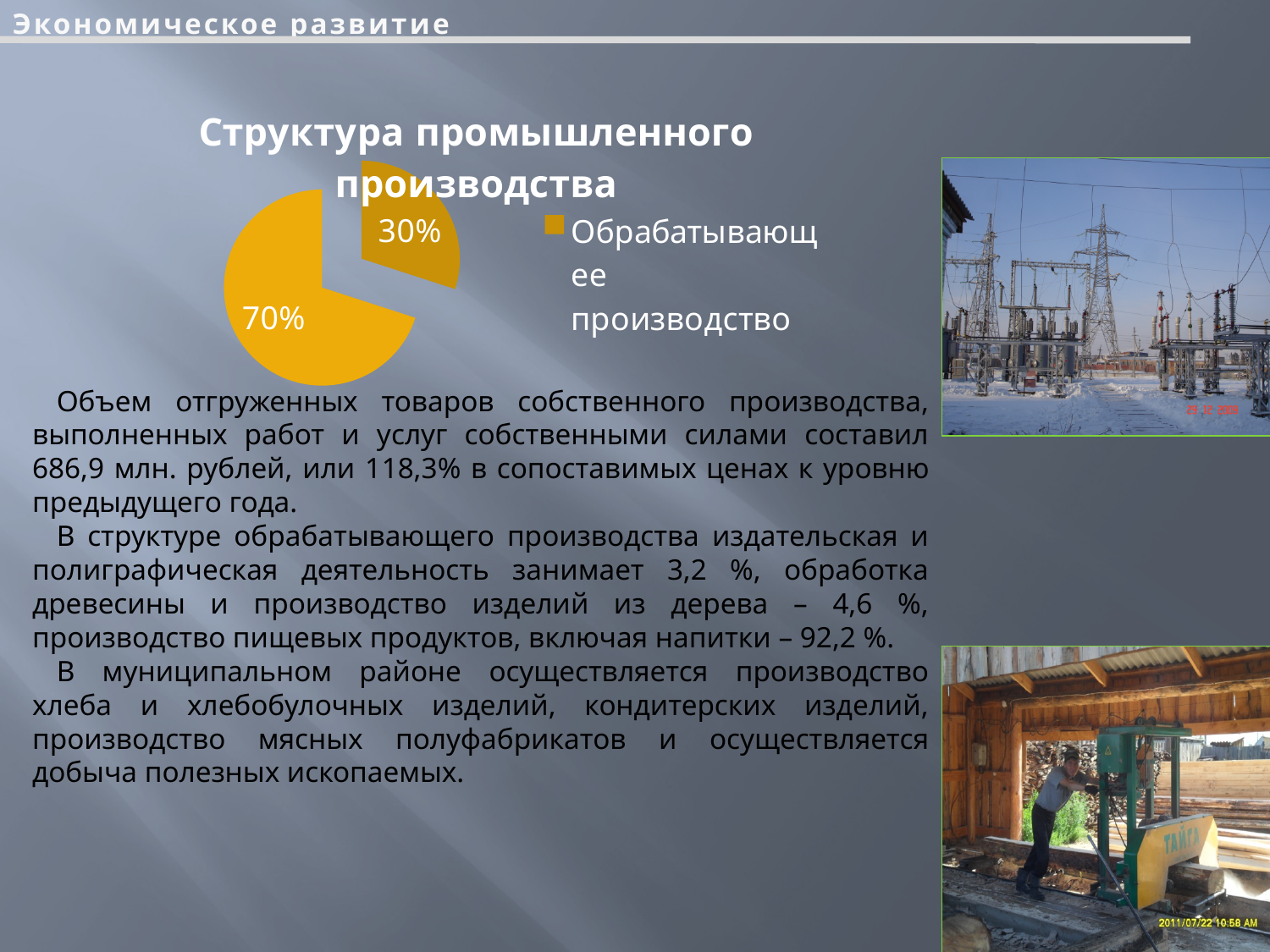
What is the title of the pie chart? Структура промышленного производства What is the value of the largest slice in the pie chart? 70% Which slice of the pie chart is pulled out (exploded) from the rest? 30% How many entries does the legend of the pie chart list? 1 What do the two slices of the pie chart add up to? 100% Is the larger slice of the pie chart greater or less than 50%? greater Is the smaller slice of the pie chart greater or less than 50%? less What kind of chart is shown under the title "Структура промышленного производства"? pie chart What is the difference between the two slices of the pie chart, in percentage points? 40 How many slices does the pie chart "Структура промышленного производства" have? 2 What is the legend entry shown next to the pie chart? Обрабатывающее производство What is the value of the smallest slice in the pie chart? 30%